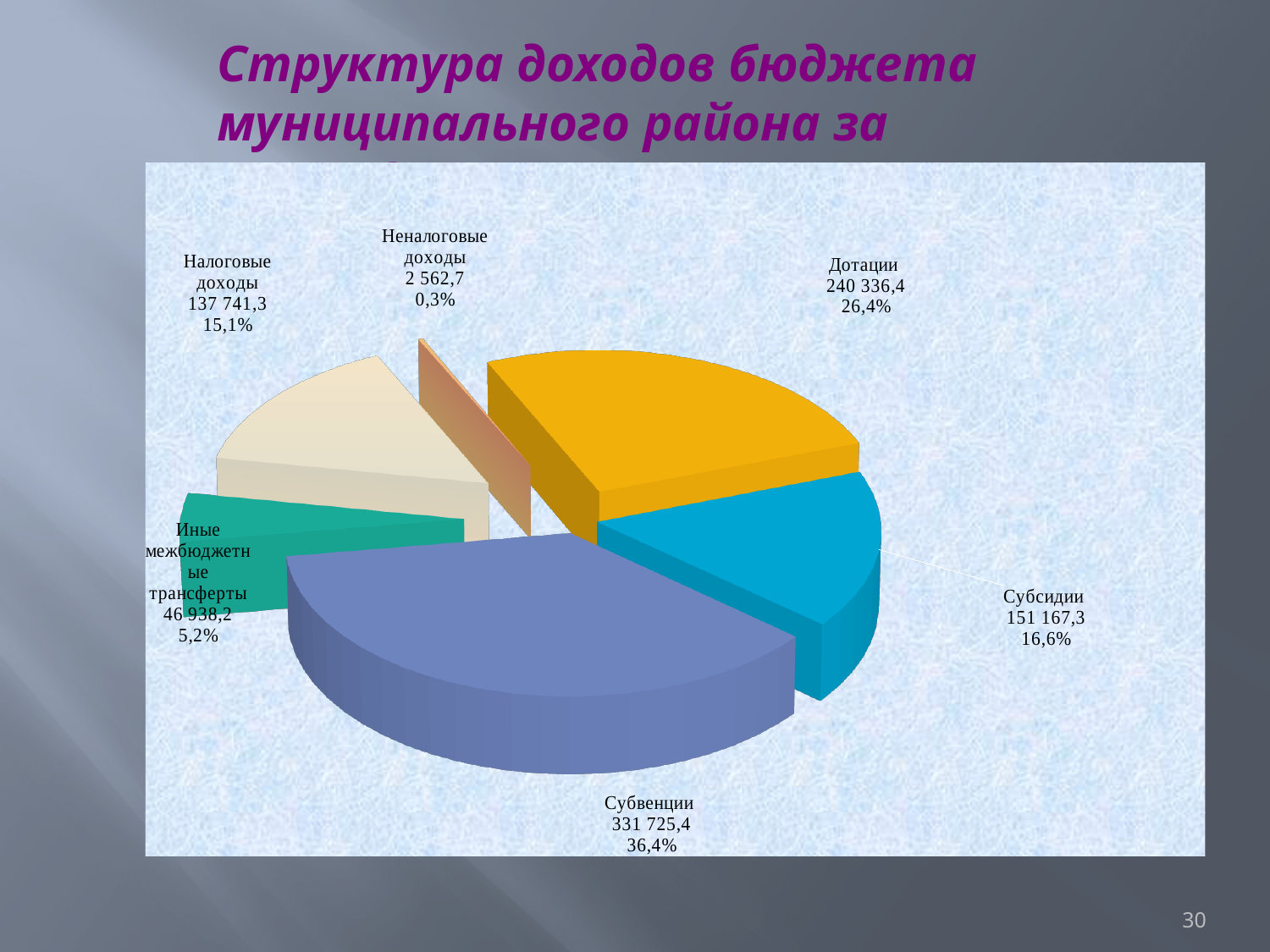
What colour is the Субвенции slice? blue-purple What is the value shown for Налоговые доходы? 137 741,3 How many slices does the pie chart have? 6 Which category has the smallest slice of the pie? Неналоговые доходы What is the value shown for Иные межбюджетные трансферты? 46 938,2 What kind of chart is shown on the slide? pie chart Which category has the largest slice of the pie? Субвенции What share of the pie does Дотации represent? 26,4% Which is larger, Субсидии or Налоговые доходы? Субсидии What is the difference between the values for Субвенции and Дотации? 91 389,0 What is the value shown for Субвенции? 331 725,4 What share of the pie does Неналоговые доходы represent? 0,3%